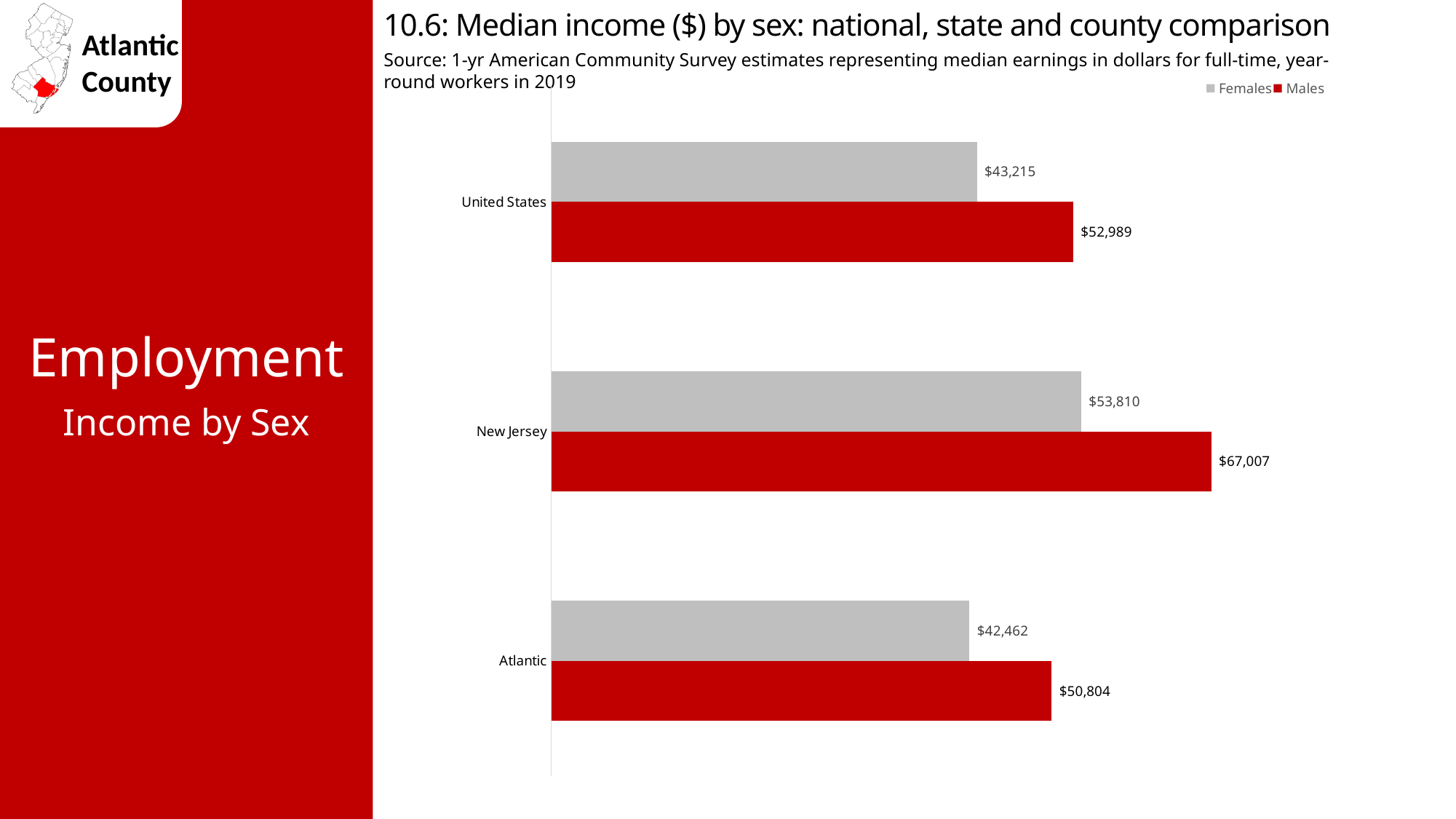
How many areas are compared in the chart? 3 What is the median income for Females in the United States? $43,215 How many series does the legend list? 2 What is the median income for Males in Atlantic? $50,804 Which area has the highest median income for Males? New Jersey What is the difference between the Males median income in New Jersey and in the United States? $14,018 Which area has the lowest median income for Females? Atlantic What is the median income for Males in New Jersey? $67,007 Which is larger: the Females median income in New Jersey or the Males median income in the United States? Females median income in New Jersey What is the difference between the Males and Females median income in New Jersey? $13,197 What is the median income for Females in Atlantic? $42,462 What type of chart is shown on the slide? Bar chart